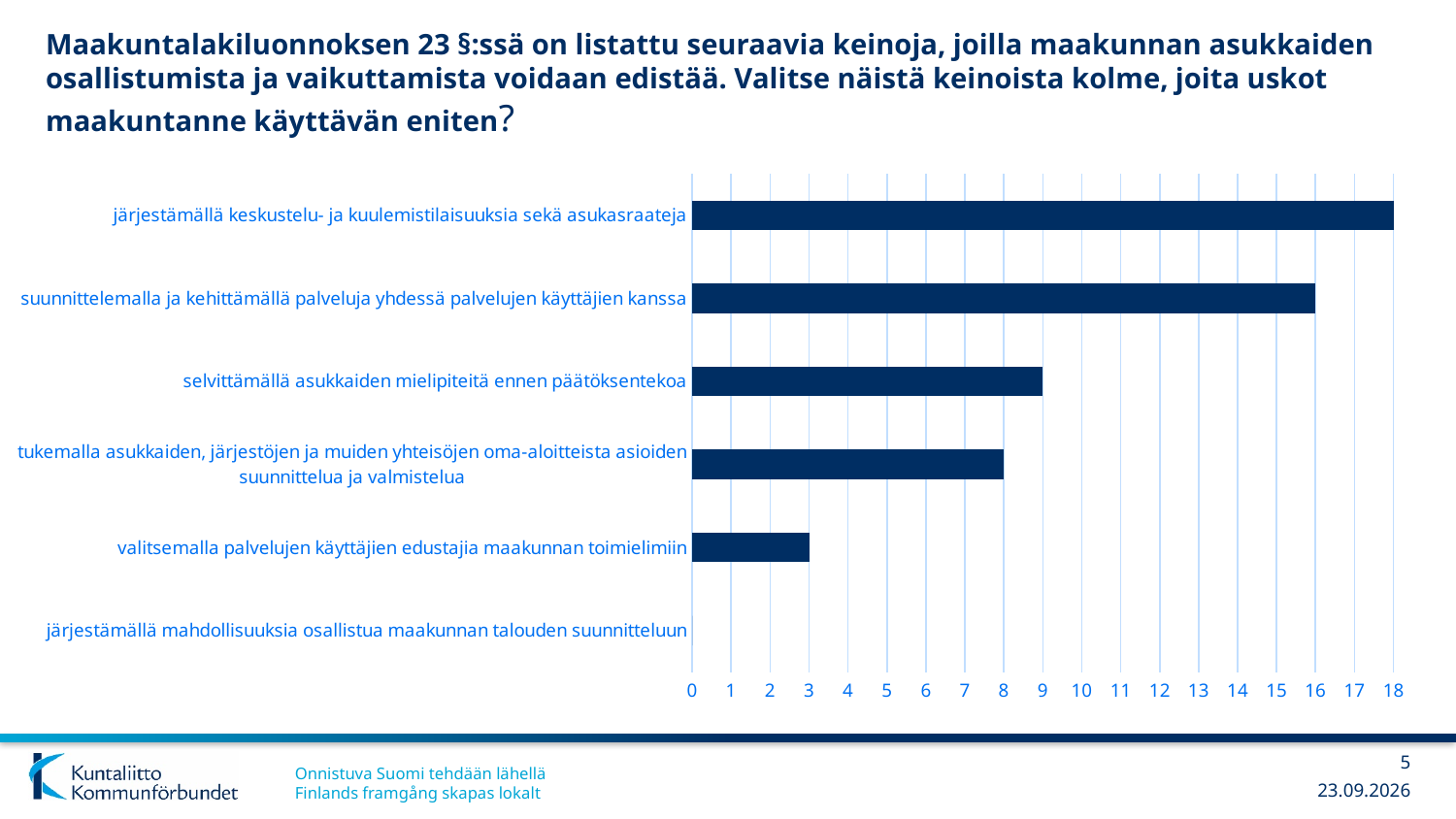
What is the value for 'valitsemalla palvelujen käyttäjien edustajia maakunnan toimielimiin'? 3 How many categories are shown in the chart? 6 Which category has the highest value? järjestämällä keskustelu- ja kuulemistilaisuuksia sekä asukasraateja Is the value for 'tukemalla asukkaiden, järjestöjen ja muiden yhteisöjen oma-aloitteista asioiden suunnittelua ja valmistelua' greater or less than 10? less Which is larger: the value for 'selvittämällä asukkaiden mielipiteitä ennen päätöksentekoa' or the value for 'valitsemalla palvelujen käyttäjien edustajia maakunnan toimielimiin'? selvittämällä asukkaiden mielipiteitä ennen päätöksentekoa What kind of chart is shown on the slide? bar chart What is the maximum value shown on the horizontal axis? 18 What is the value for 'suunnittelemalla ja kehittämällä palveluja yhdessä palvelujen käyttäjien kanssa'? 16 What is the difference between the values for 'järjestämällä keskustelu- ja kuulemistilaisuuksia sekä asukasraateja' and 'suunnittelemalla ja kehittämällä palveluja yhdessä palvelujen käyttäjien kanssa'? 2 What is the value for 'selvittämällä asukkaiden mielipiteitä ennen päätöksentekoa'? 9 Which category has the lowest value? järjestämällä mahdollisuuksia osallistua maakunnan talouden suunnitteluun What is the value for 'järjestämällä keskustelu- ja kuulemistilaisuuksia sekä asukasraateja'? 18